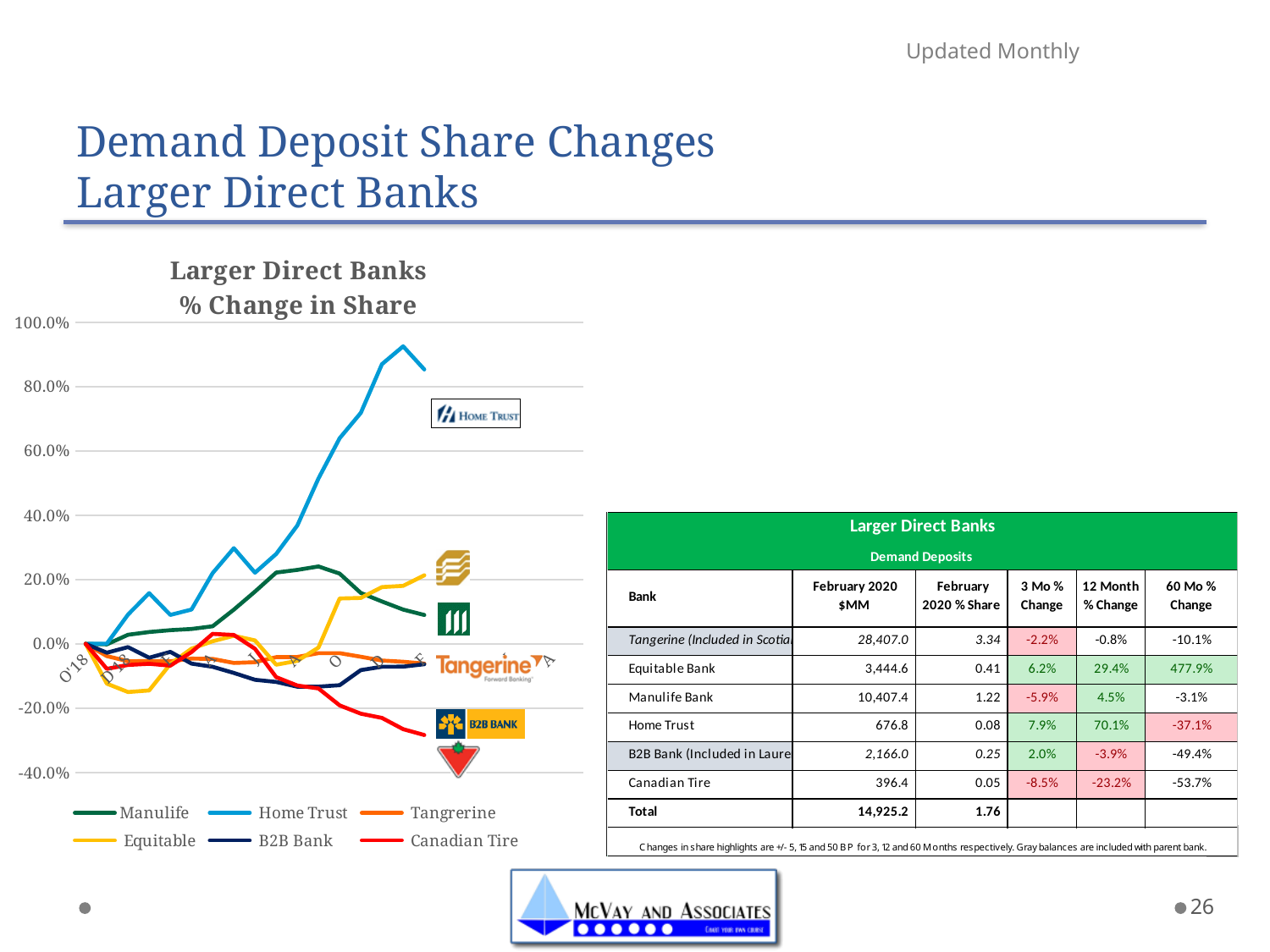
Is the peak value of the Home Trust line greater or less than 80.0%? greater How many series does the legend of the chart list? 6 Which series has the highest value at the right end of the chart? Home Trust Does the Canadian Tire line overall rise or fall from left to right? fall Does the Home Trust line overall rise or fall from left to right? rise Which series has the lowest value at the right end of the chart? Canadian Tire At the right end of the chart, which is larger: the value for Home Trust or the value for Canadian Tire? Home Trust What colour is the Home Trust line in the chart? Light blue What is the title of the chart? Larger Direct Banks % Change in Share What kind of chart is shown on the slide? Line chart Is the value for Manulife at the right end of the chart greater or less than 0.0%? greater Is the value for Canadian Tire at the right end of the chart greater or less than -20.0%? less